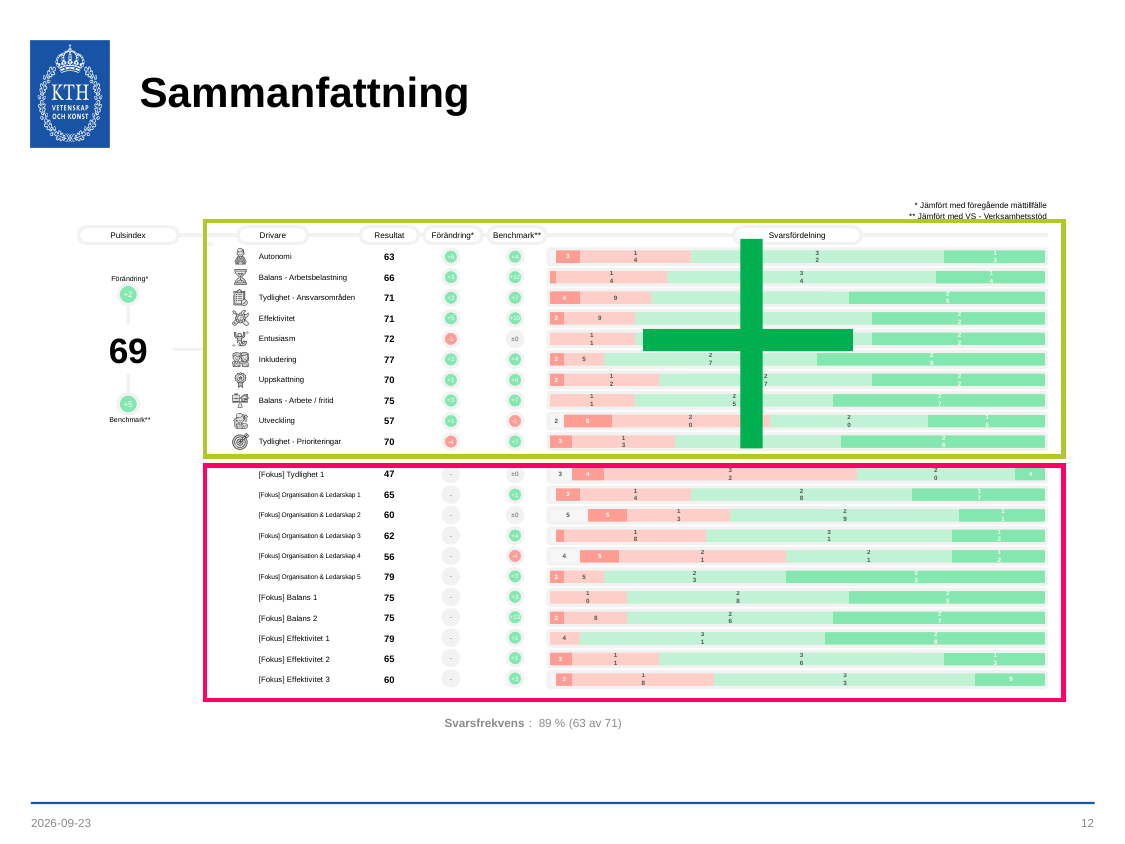
What kind of chart is used in the Svarsfördelning column? Stacked bar chart Which has a higher Resultat, Autonomi or Entusiasm? Entusiasm What is the Resultat value for Utveckling? 57 Which driver in the upper (green-framed) section has the highest Resultat? Inkludering What is the Pulsindex value shown on the slide? 69 What is the Resultat value for Inkludering? 77 What is the difference in Resultat between Inkludering and Utveckling? 20 Which driver in the upper (green-framed) section has the lowest Resultat? Utveckling What Svarsfrekvens (response rate) is stated below the table? 89 % (63 av 71) Which row in the lower (pink-framed) Fokus section has the lowest Resultat? [Fokus] Tydlighet 1 What is the Resultat value for [Fokus] Tydlighet 1? 47 How many driver rows are listed in the upper (green-framed) section? 10